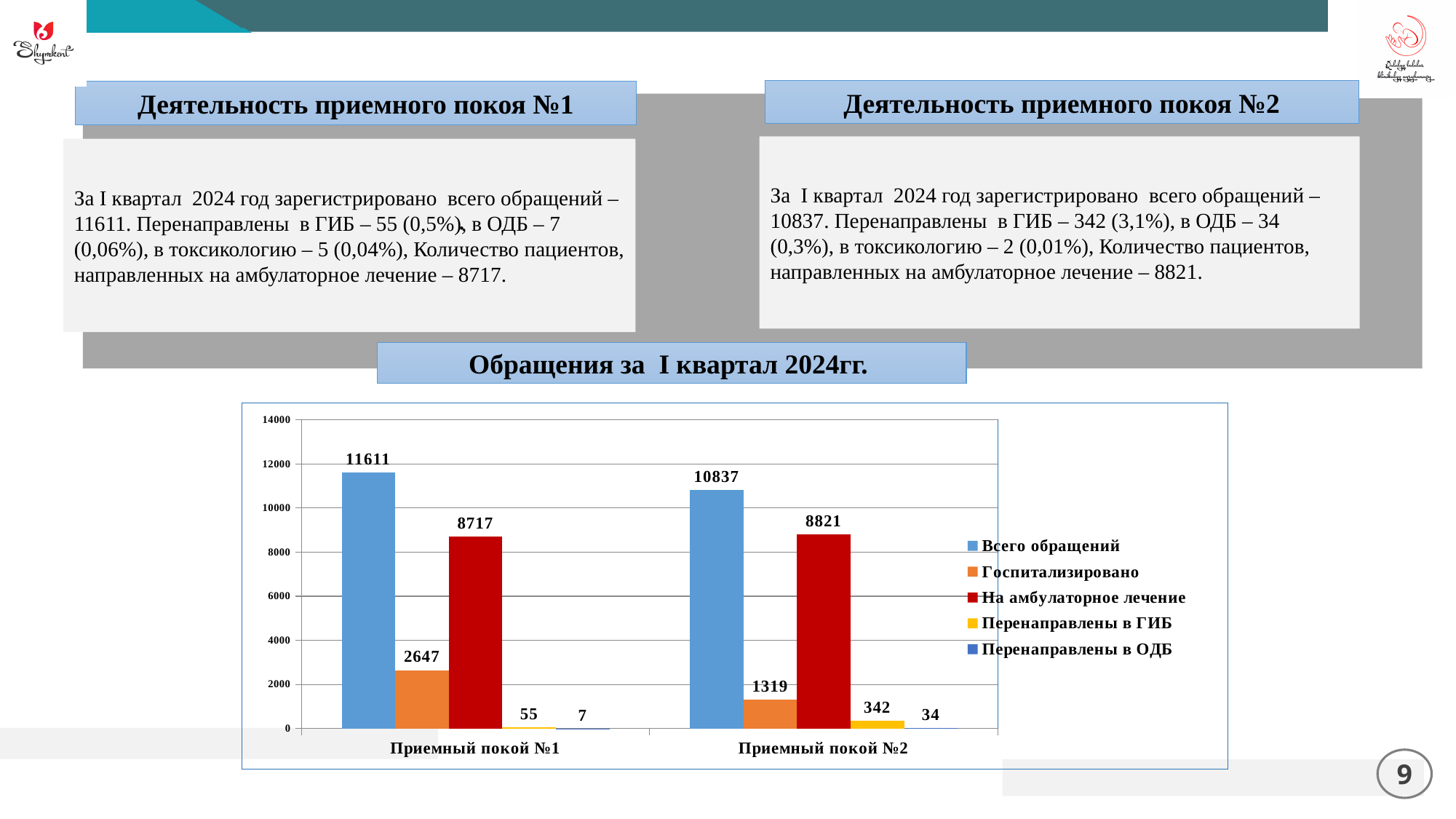
What is the value of Госпитализировано for Приемный покой №2? 1319 What is the value of Перенаправлены в ОДБ for Приемный покой №2? 34 What is the value of На амбулаторное лечение for Приемный покой №2? 8821 How many categories are shown on the x axis? 2 Which category has the higher value for Всего обращений? Приемный покой №1 Which is larger: На амбулаторное лечение for Приемный покой №1 or for Приемный покой №2? Приемный покой №2 What kind of chart is shown on the slide? bar chart What is the value of Всего обращений for Приемный покой №1? 11611 How many series does the legend list? 5 What is the difference between Госпитализировано for Приемный покой №1 and Приемный покой №2? 1328 Is the value of Госпитализировано for Приемный покой №1 greater or less than 2000? greater What is the value of Перенаправлены в ГИБ for Приемный покой №1? 55